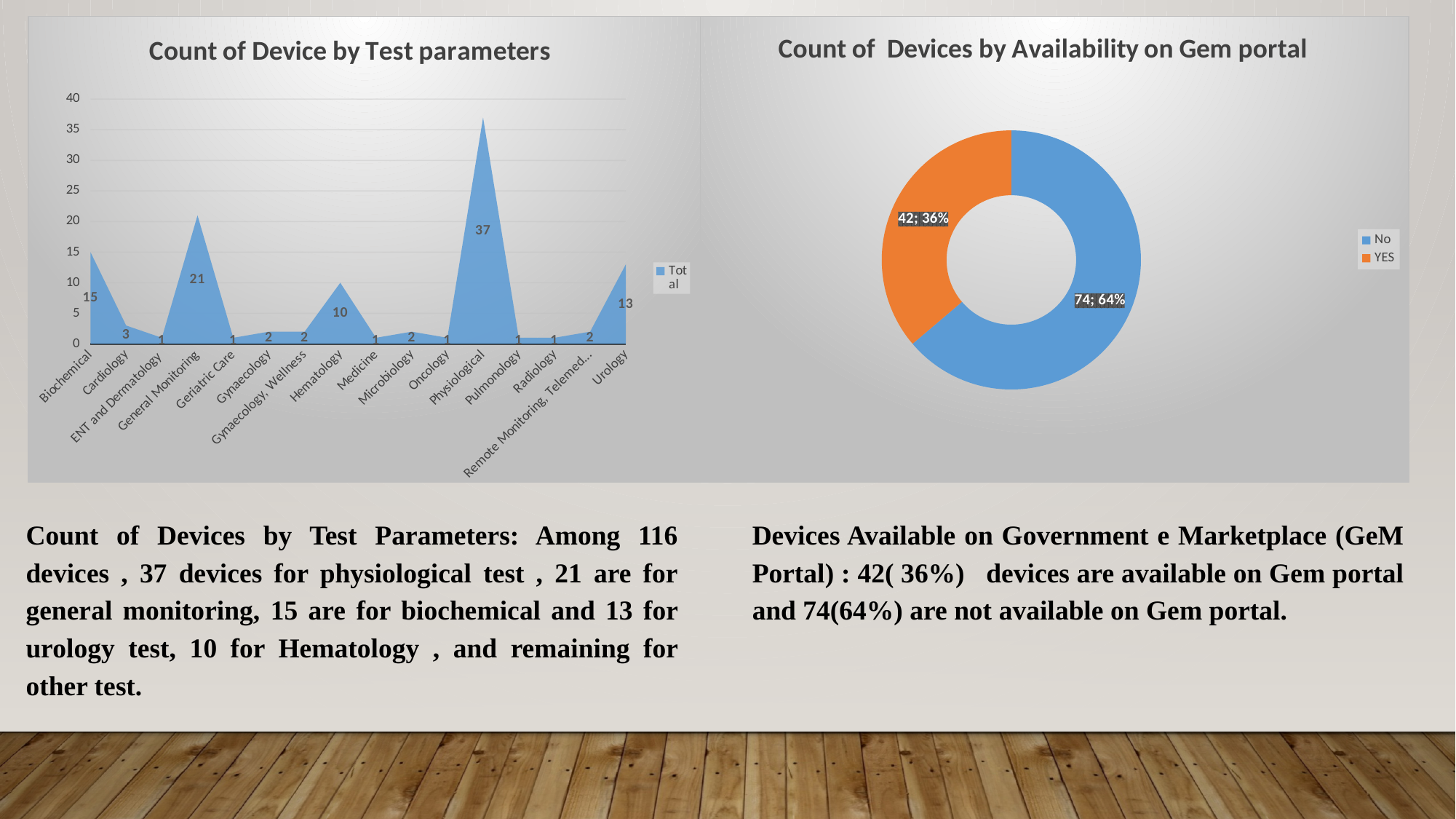
How many categories are shown on the x axis of the 'Count of Device by Test parameters' chart? 16 In the 'Count of Device by Test parameters' chart, what is the value for Physiological? 37 How many series does the legend of the 'Count of Devices by Availability on Gem portal' chart list? 2 In the 'Count of Devices by Availability on Gem portal' chart, what is the value for No? 74 In the 'Count of Device by Test parameters' chart, which category has the highest value? Physiological What type of chart is 'Count of Devices by Availability on Gem portal'? Doughnut chart In the 'Count of Device by Test parameters' chart, what is the value for General Monitoring? 21 In the 'Count of Device by Test parameters' chart, what is the difference between the values for Physiological and General Monitoring? 16 In the 'Count of Device by Test parameters' chart, which is larger, the value for Biochemical or the value for Urology? Biochemical In the 'Count of Device by Test parameters' chart, what is the value for Hematology? 10 What type of chart is 'Count of Device by Test parameters'? Area chart In the 'Count of Devices by Availability on Gem portal' chart, what share of the total does YES represent? 36%